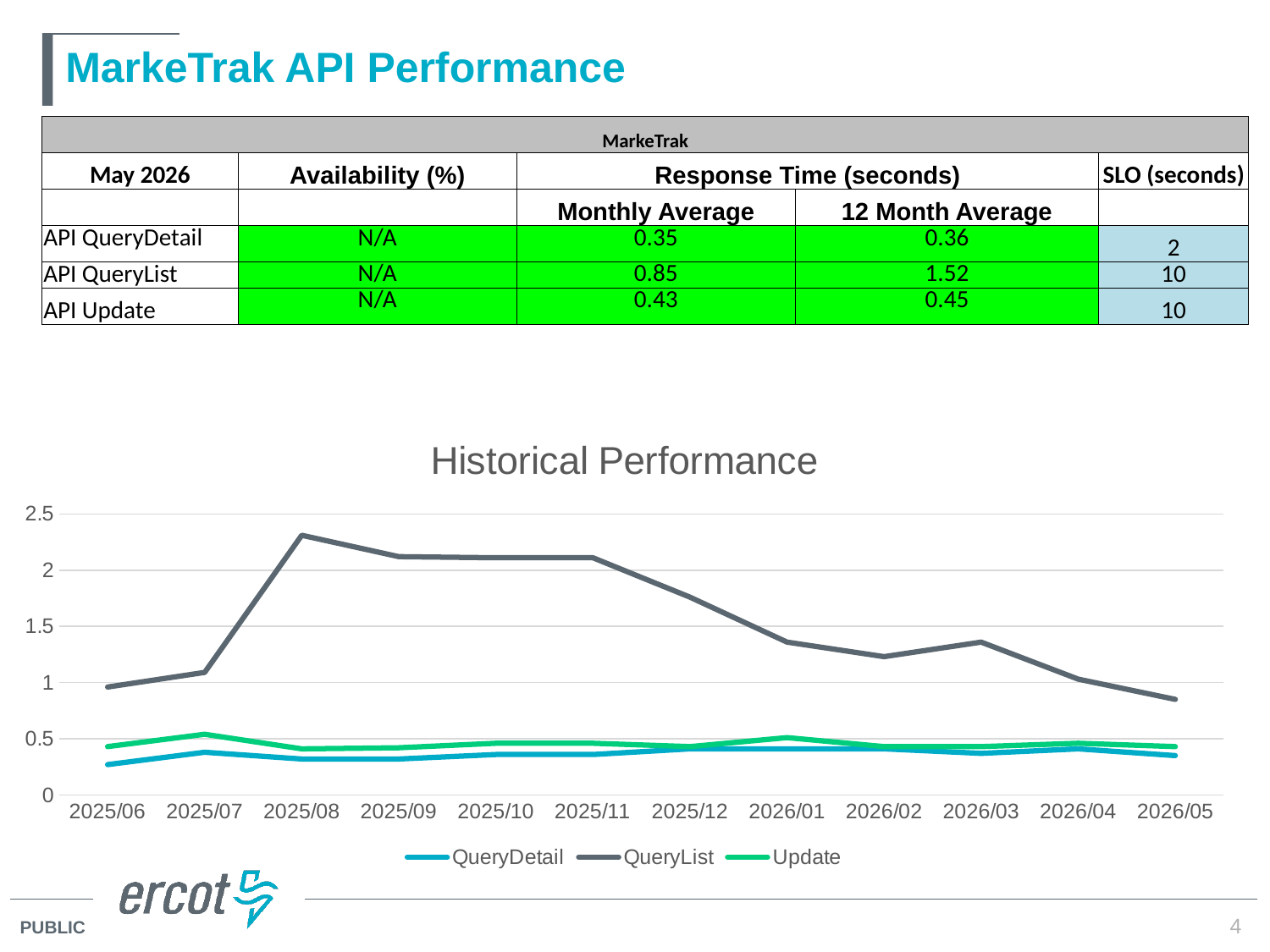
What kind of chart is the Historical Performance chart? line chart Is the QueryDetail value for 2025/06 greater or less than 0.5? less How many months are shown on the x axis of the Historical Performance chart? 12 Is the QueryList value for 2026/05 greater or less than 1? less How many series does the legend of the Historical Performance chart list? 3 Is the QueryList value for 2025/08 greater or less than 2? greater In which month is the QueryList series lowest in the Historical Performance chart? 2026/05 Does the QueryList series rise or fall from 2025/08 to 2025/12? fall At 2025/08, which series has the larger value, QueryList or QueryDetail? QueryList Which series reaches the highest value in the Historical Performance chart? QueryList In which month does the QueryList series peak in the Historical Performance chart? 2025/08